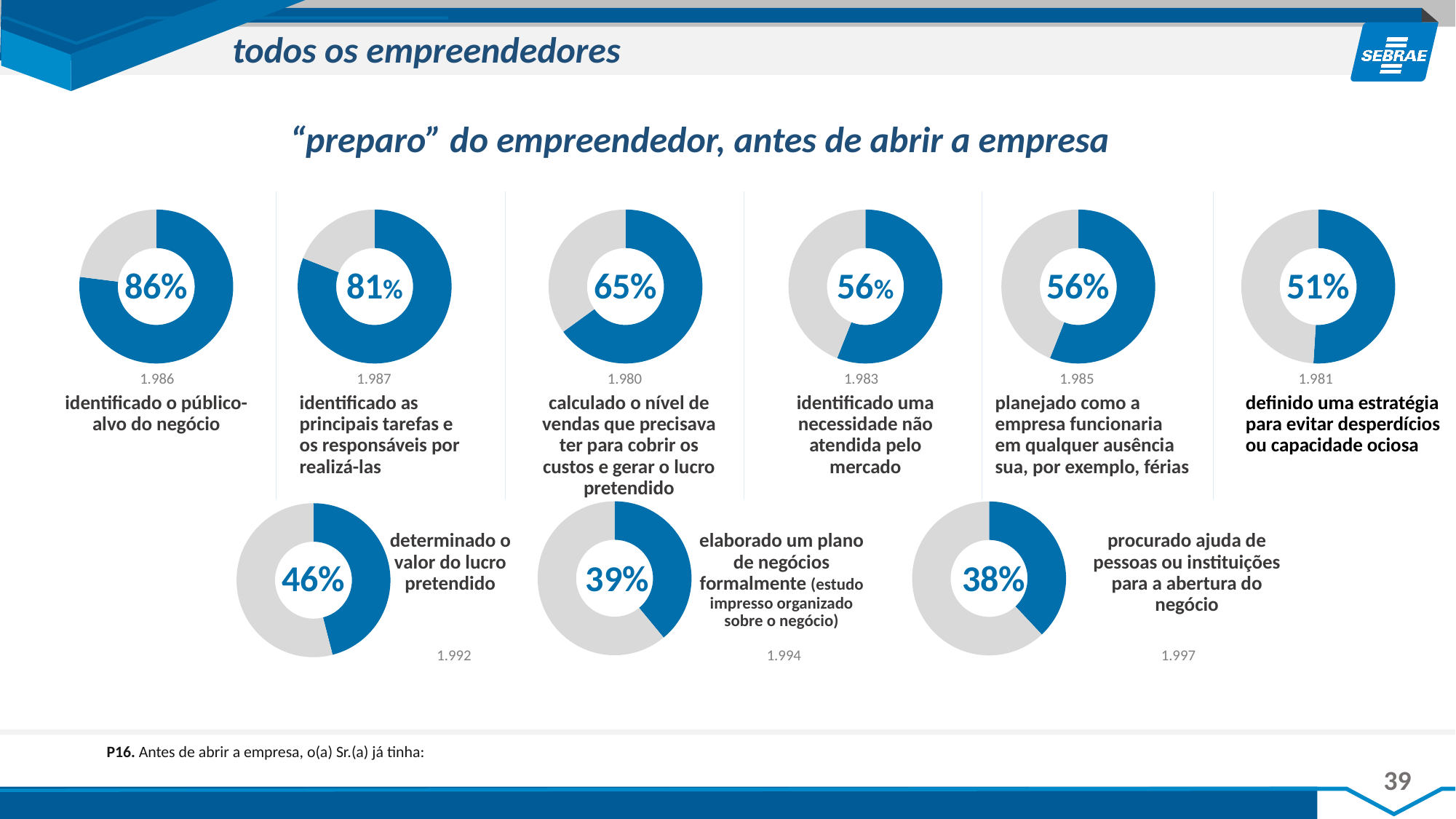
What is the sample size (n) printed below the donut chart for "procurado ajuda de pessoas ou instituições para a abertura do negócio"? 1.997 Which has a higher percentage: "calculado o nível de vendas..." or "identificado uma necessidade não atendida pelo mercado"? calculado o nível de vendas que precisava ter para cobrir os custos e gerar o lucro pretendido What percentage is shown for "definido uma estratégia para evitar desperdícios ou capacidade ociosa"? 51% Which item has the highest percentage among the donut charts on the slide? identificado o público-alvo do negócio What is the title of the slide's chart section, shown above the donut charts? "preparo" do empreendedor, antes de abrir a empresa What is the sample size printed below the donut chart for "identificado as principais tarefas e os responsáveis por realizá-las"? 1.987 Which item has the lowest percentage among the donut charts on the slide? procurado ajuda de pessoas ou instituições para a abertura do negócio What percentage of entrepreneurs had identified the target audience of the business ("identificado o público-alvo do negócio") before opening the company? 86% How many donut charts are shown on the slide? 9 What type of chart is used to display each percentage on the slide? Donut chart What percentage is shown in the donut chart for "elaborado um plano de negócios formalmente"? 39% What is the difference in percentage points between "identificado o público-alvo do negócio" and "determinado o valor do lucro pretendido"? 40